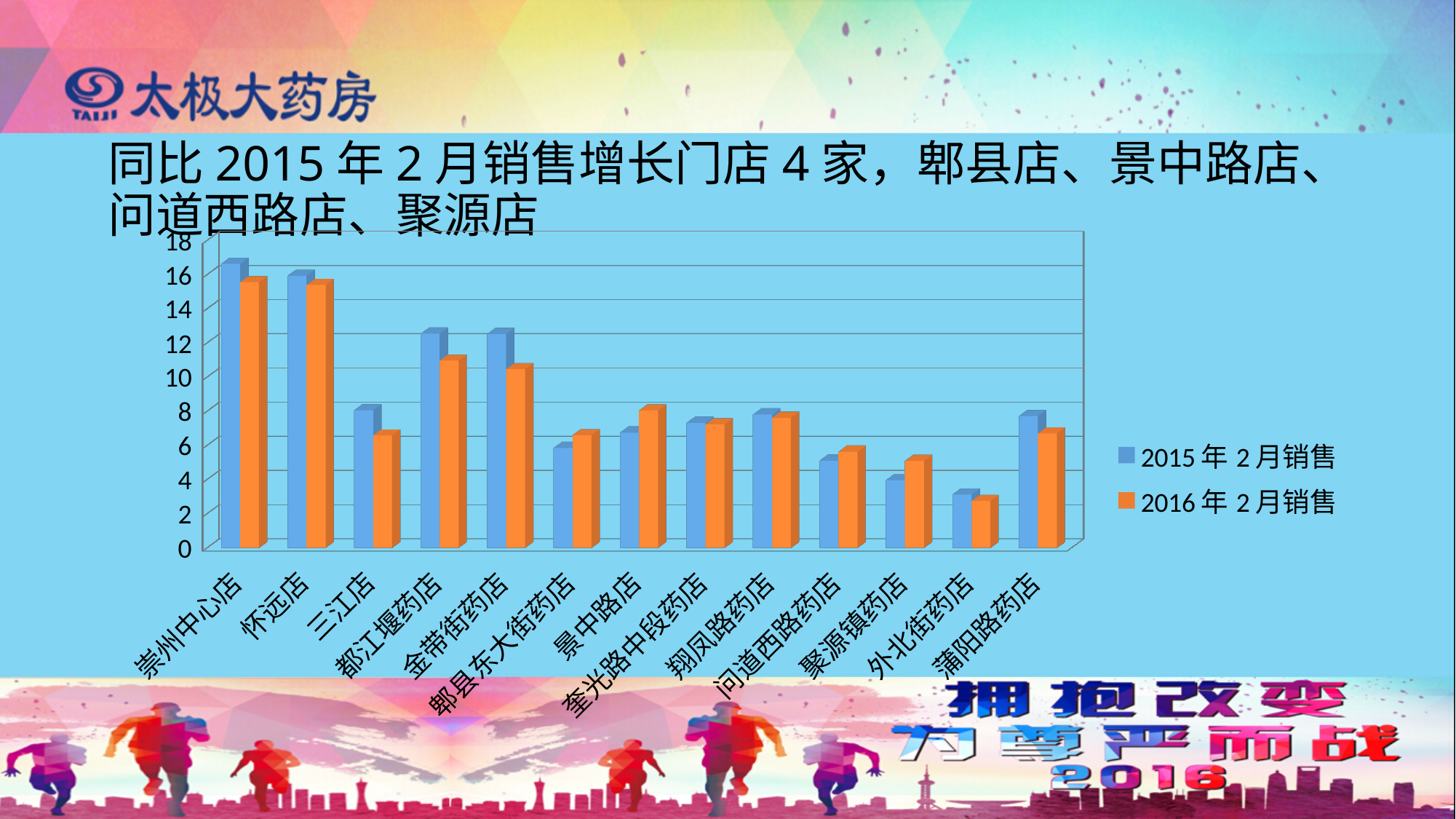
Which store has the lowest 2016年2月销售 value? 外北街药店 How many series does the legend list? 2 Is the 2016年2月销售 value for 三江店 greater or less than 8? less For 崇州中心店, which is larger: 2015年2月销售 or 2016年2月销售? 2015年2月销售 What kind of chart is shown on the slide? bar chart How many stores (categories) are shown on the x axis? 13 Is the 2015年2月销售 value for 崇州中心店 greater or less than 14? greater Is the 2015年2月销售 value for 外北街药店 greater or less than 4? less For 三江店, which is larger: 2015年2月销售 or 2016年2月销售? 2015年2月销售 For 景中路店, which is larger: 2015年2月销售 or 2016年2月销售? 2016年2月销售 What colour are the bars for the 2016年2月销售 series? orange Which store has the lowest 2015年2月销售 value? 外北街药店